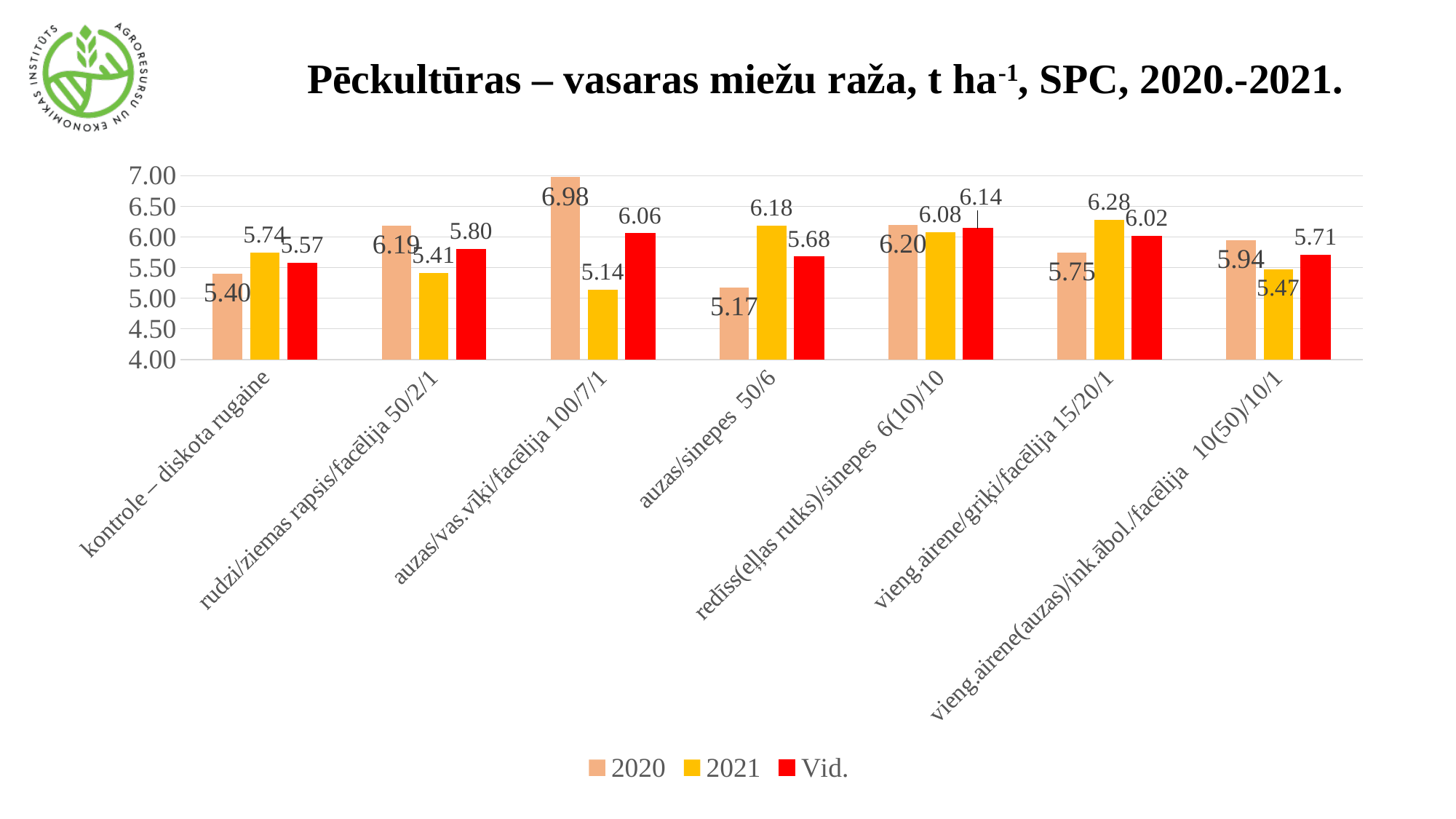
Which category has the highest Vid. value? redīss(eļļas rutks)/sinepes 6(10)/10 Which category has the lowest 2021 value? auzas/vas.vīķi/facēlija 100/7/1 What is the difference between the 2020 and 2021 values for auzas/vas.vīķi/facēlija 100/7/1? 1.84 What is the Vid. value for kontrole – diskota rugaine? 5.57 Which category has the highest 2020 value? auzas/vas.vīķi/facēlija 100/7/1 What kind of chart is shown on the slide? bar chart How many categories are shown on the x axis? 7 What is the 2020 value for auzas/sinepes 50/6? 5.17 How many series does the legend list? 3 What are the legend entries of the chart? 2020, 2021, Vid. Which is larger: the 2021 value for kontrole – diskota rugaine or the 2021 value for rudzi/ziemas rapsis/facēlija 50/2/1? kontrole – diskota rugaine What is the 2021 value for vieng.airene/griķi/facēlija 15/20/1? 6.28